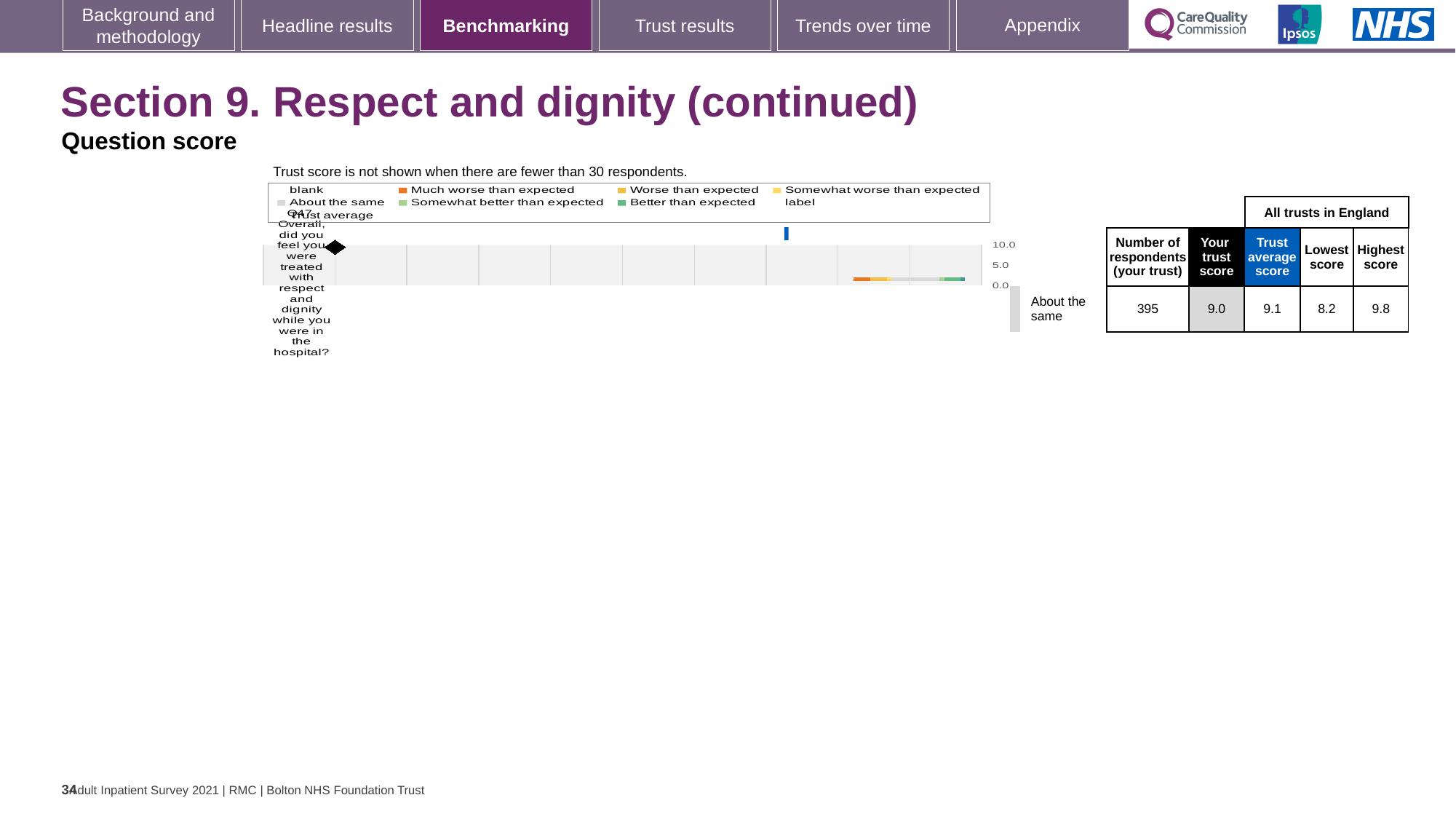
What kind of chart is used to show the Q47 benchmarking result? Bar chart What is the difference between the highest score and the lowest score for Q47 across all trusts in England? 1.6 How many respondents from the trust answered Q47? 395 What is the highest score among all trusts in England for Q47? 9.8 What is the trust score for Q47 shown in the table? 9.0 What is the trust average score for Q47 across all trusts in England? 9.1 What colour represents 'Much worse than expected' in the chart legend? Orange What is the lowest score among all trusts in England for Q47? 8.2 What benchmark category is the trust's Q47 score placed in? About the same What is the maximum value shown on the chart's score axis? 10.0 Which is larger for Q47: the trust's own score or the trust average score? Trust average score How many questions are plotted on the chart? 1